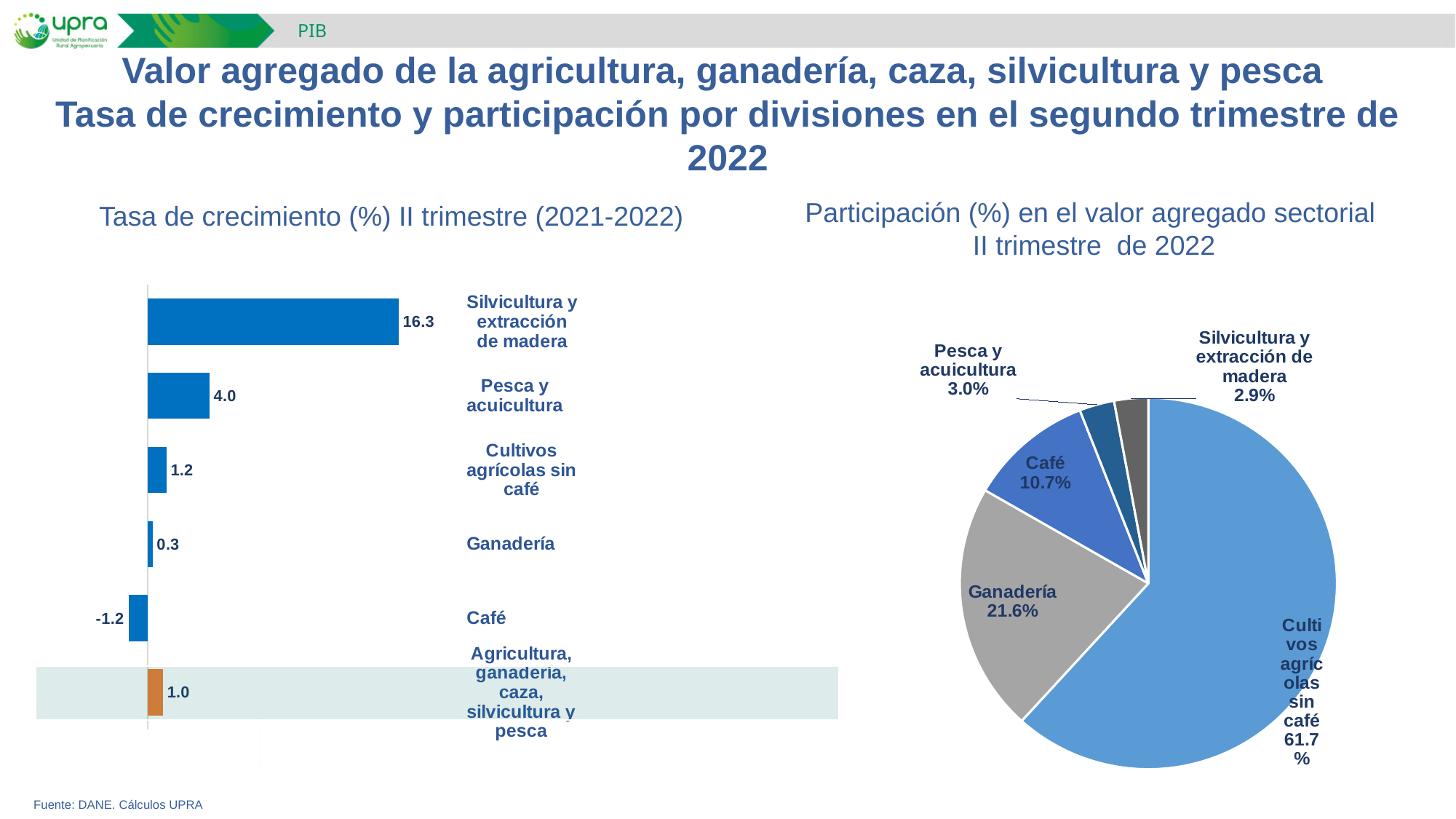
In the 'Tasa de crecimiento (%) II trimestre (2021-2022)' chart, what is the value for Café? -1.2 In the 'Tasa de crecimiento (%) II trimestre (2021-2022)' chart, what is the value for Silvicultura y extracción de madera? 16.3 In the 'Participación (%) en el valor agregado sectorial II trimestre de 2022' chart, what share does Ganadería have? 21.6% How many bars are shown in the 'Tasa de crecimiento (%) II trimestre (2021-2022)' chart? 6 In the 'Tasa de crecimiento (%) II trimestre (2021-2022)' chart, which category has the highest value? Silvicultura y extracción de madera In the 'Tasa de crecimiento (%) II trimestre (2021-2022)' chart, which category has the lowest value? Café In the 'Participación (%) en el valor agregado sectorial II trimestre de 2022' chart, what share does Café have? 10.7% In the 'Tasa de crecimiento (%) II trimestre (2021-2022)' chart, which is larger, the value for Cultivos agrícolas sin café or the value for Ganadería? Cultivos agrícolas sin café In the 'Participación (%) en el valor agregado sectorial II trimestre de 2022' chart, which category has the largest slice? Cultivos agrícolas sin café What kind of chart is the 'Participación (%) en el valor agregado sectorial II trimestre de 2022' chart? Pie chart What kind of chart is the 'Tasa de crecimiento (%) II trimestre (2021-2022)' chart? Bar chart In the 'Tasa de crecimiento (%) II trimestre (2021-2022)' chart, what is the difference between the values for Silvicultura y extracción de madera and Pesca y acuicultura? 12.3